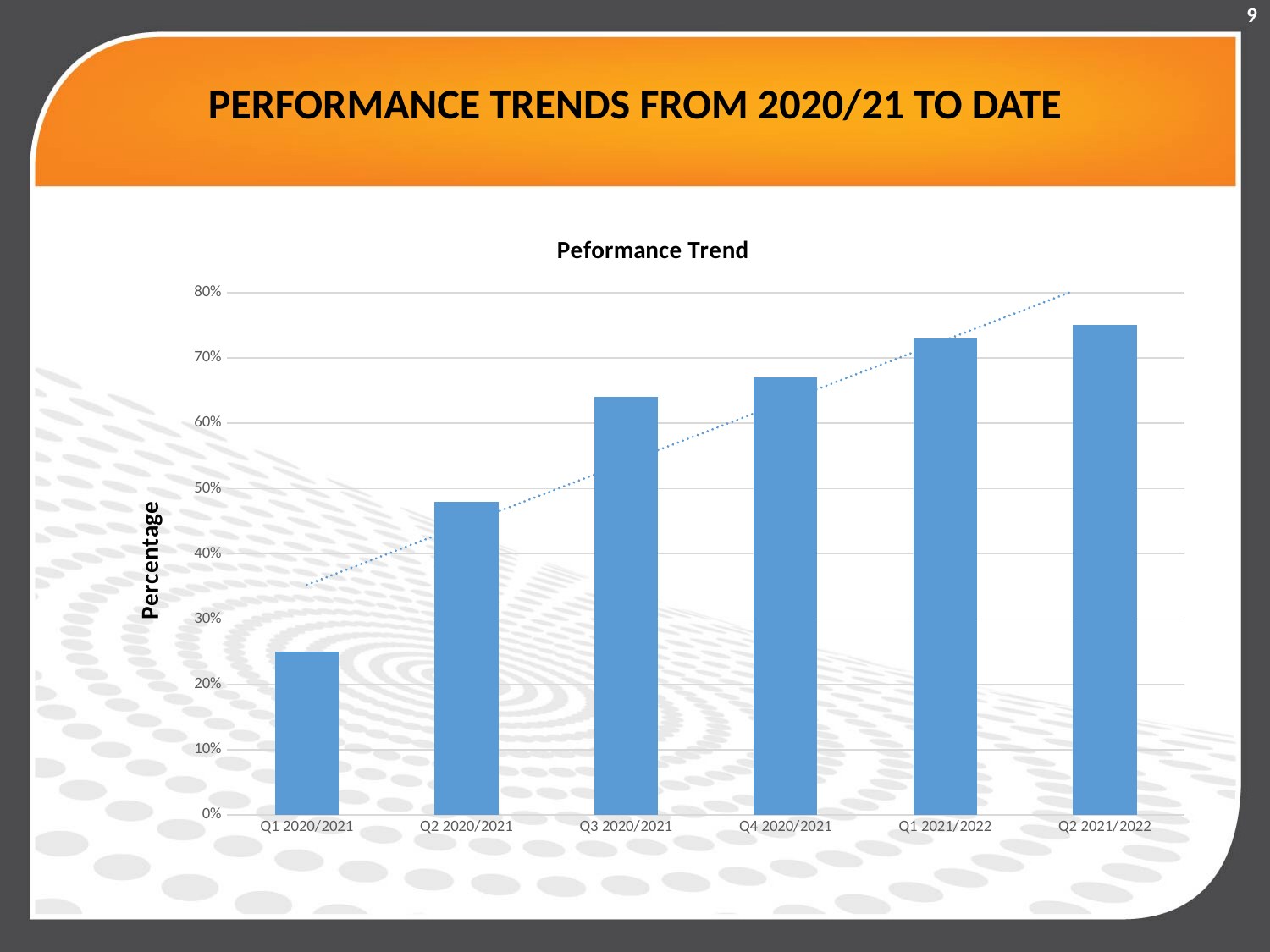
Which quarter has the lowest value on the chart? Q1 2020/2021 Do the values rise or fall from Q1 2020/2021 to Q2 2021/2022? Rise What kind of chart is shown on the slide? Bar chart What is the label on the vertical axis of the chart? Percentage Is the value for Q2 2020/2021 greater or less than 50%? less Which quarter has the highest value on the chart? Q2 2021/2022 How many quarters are plotted on the chart? 6 Is the value for Q1 2020/2021 greater or less than 30%? less Is the value for Q3 2020/2021 greater or less than 60%? greater Which is larger, the value for Q1 2020/2021 or the value for Q2 2020/2021? Q2 2020/2021 What is the title of the chart? Peformance Trend